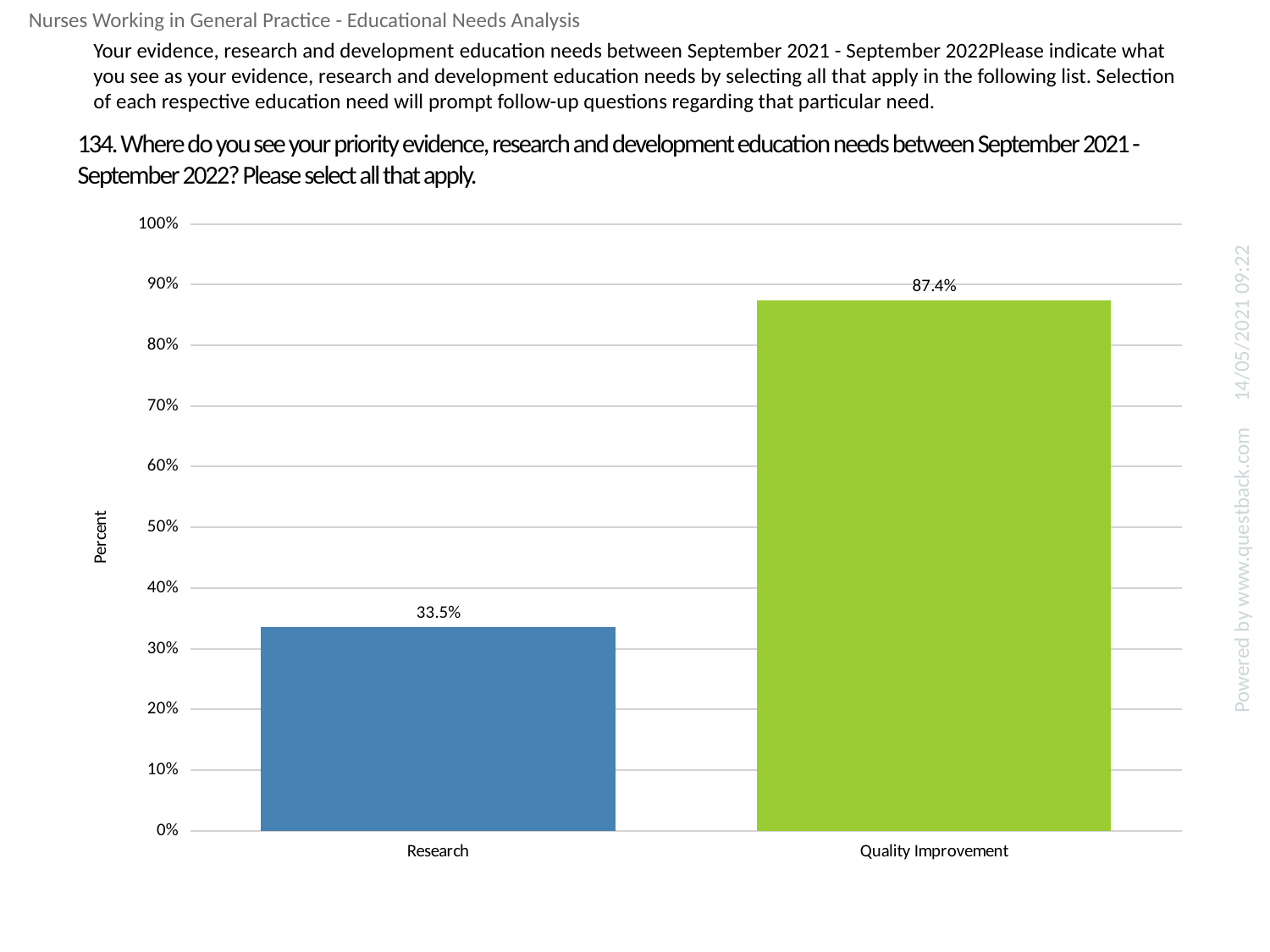
What is the value for Quality Improvement? 87.4% Which is larger, the value for Research or the value for Quality Improvement? Quality Improvement Is the value for Quality Improvement greater or less than 80%? greater What is the label of the vertical axis? Percent What is the value for Research? 33.5% What kind of chart is shown on the slide? Bar chart What colour is the bar for Quality Improvement? Green Is the value for Research greater or less than 40%? less Which category has the highest value? Quality Improvement Which category has the lowest value? Research What is the difference between the values for Quality Improvement and Research? 53.9% How many categories are shown on the chart? 2